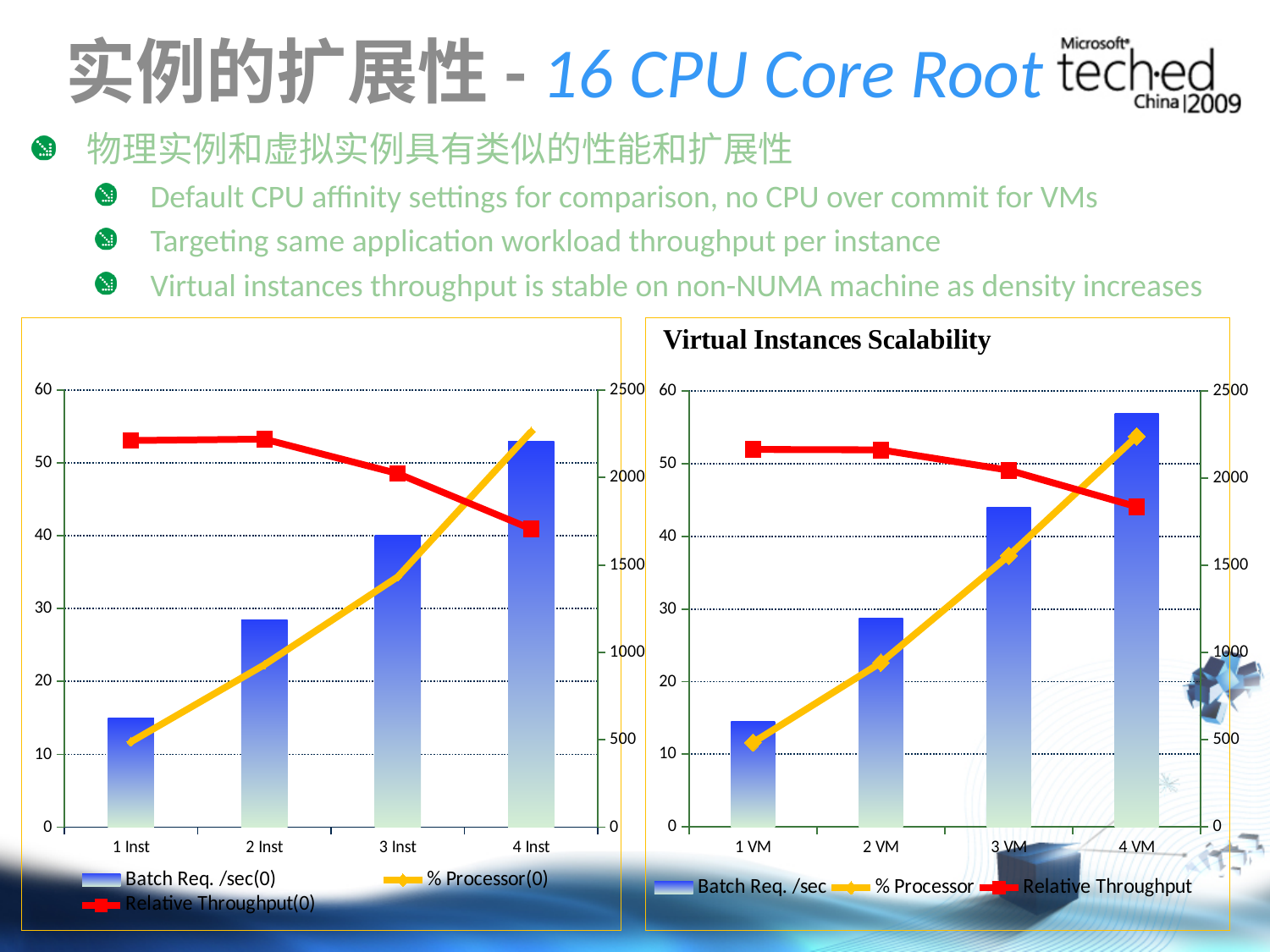
In the Virtual Instances Scalability chart, which category has the highest Batch Req. /sec bar? 4 VM In the chart on the left side of the slide, does the % Processor(0) line rise or fall from 1 Inst to 4 Inst? rises In the Virtual Instances Scalability chart, which category has the lowest Batch Req. /sec bar? 1 VM In the chart on the left side of the slide, is the Batch Req. /sec(0) value for 3 Inst greater or less than 30? greater In the Virtual Instances Scalability chart, is the Relative Throughput value for 4 VM greater or less than 2000? less In the chart on the left side of the slide, is the Relative Throughput(0) value for 1 Inst greater or less than 2000? less What is the title of the chart on the right side of the slide? Virtual Instances Scalability In the chart on the left side of the slide, how many categories are shown on the x axis? 4 In the chart on the left side of the slide, which has the larger Batch Req. /sec(0) bar, 1 Inst or 4 Inst? 4 Inst In the Virtual Instances Scalability chart, does the Relative Throughput line rise or fall from 1 VM to 4 VM? falls In the chart on the left side of the slide, how many series does the legend list? 3